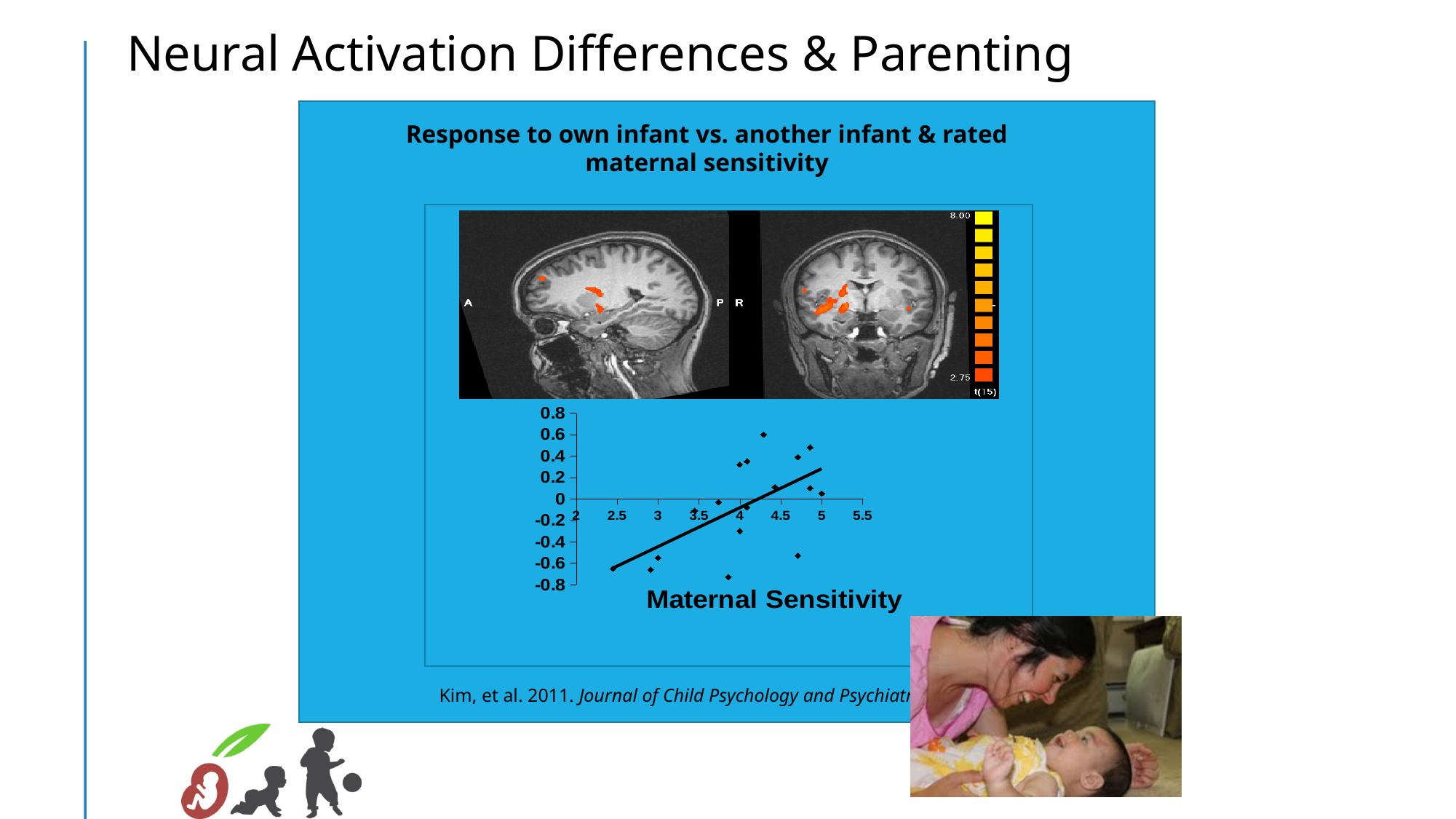
What is the lowest tick value shown on the y axis of the scatter plot? -0.8 Do the values in the scatter plot tend to rise or fall as Maternal Sensitivity increases along the x axis? rise What is the largest tick value shown on the x axis of the scatter plot? 5.5 Is the highest data point in the scatter plot greater or less than 0.4? greater What is the title above the chart panel? Response to own infant vs. another infant & rated maternal sensitivity What is the label of the x axis of the scatter plot? Maternal Sensitivity What is the highest tick value shown on the y axis of the scatter plot? 0.8 What is the maximum value shown on the colour scale bar next to the brain images? 8.00 Is the data point with the lowest Maternal Sensitivity (near 2.5) greater or less than 0 on the y axis? less Is the lowest data point in the scatter plot greater or less than -0.6? less What is the smallest tick value shown on the x axis of the scatter plot? 2 What kind of chart is shown below the brain images? scatter plot